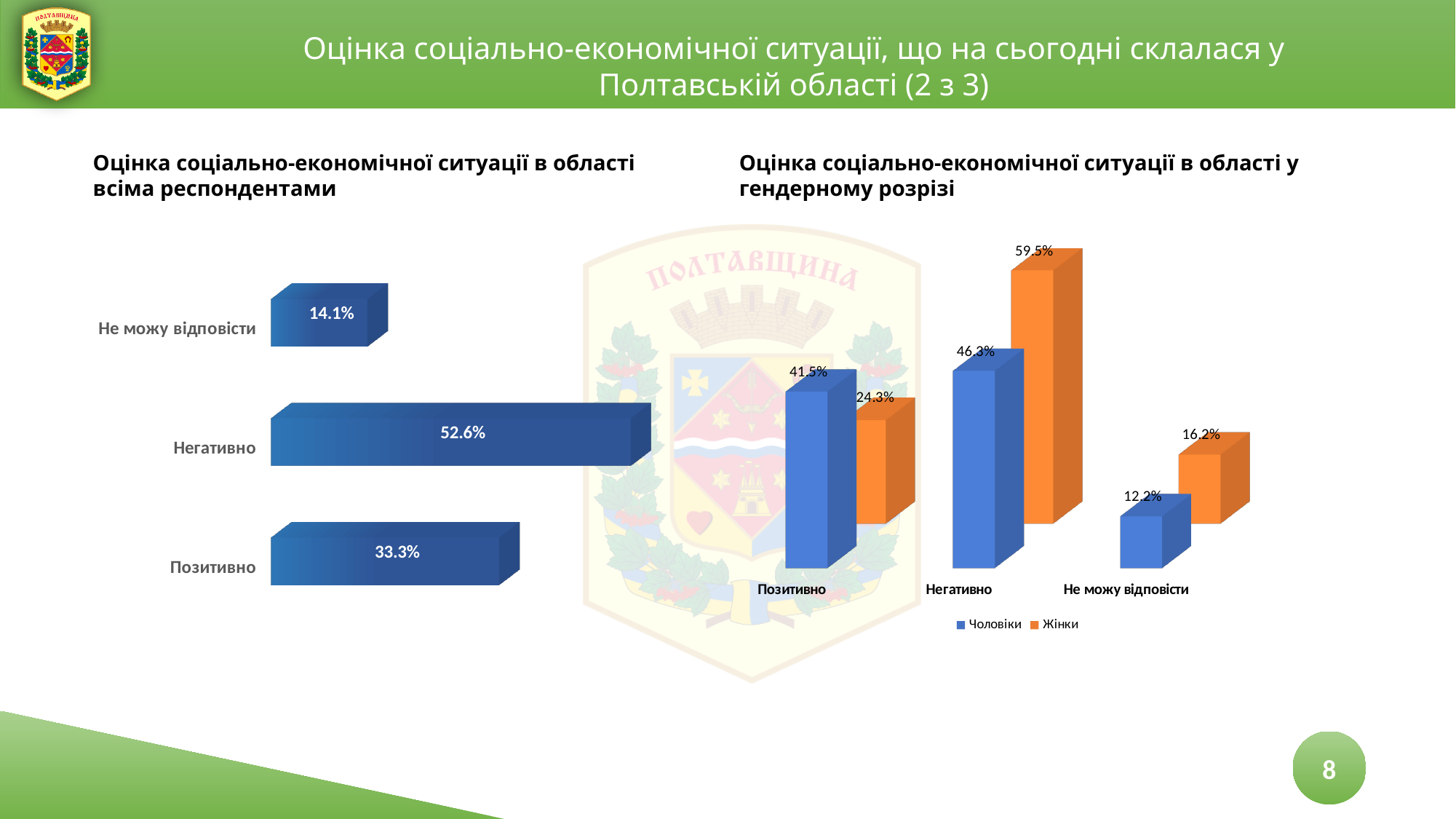
In the right chart (gender breakdown), how many series does the legend list? 2 In the left chart (all respondents), what is the value for Не можу відповісти? 14.1% In the right chart (gender breakdown), what is the value for Жінки in the Негативно category? 59.5% In the left chart (all respondents), what is the difference between Негативно and Позитивно? 19.3% In the left chart (all respondents), what is the value for Негативно? 52.6% In the right chart (gender breakdown), what is the difference between Жінки and Чоловіки in the Не можу відповісти category? 4.0% In the left chart (all respondents), which category has the lowest value? Не можу відповісти In the right chart (gender breakdown), which is larger for Позитивно: Чоловіки or Жінки? Чоловіки In the right chart (gender breakdown), what is the value for Чоловіки in the Позитивно category? 41.5% In the left chart (all respondents), how many categories are shown? 3 In the left chart (all respondents), which category has the highest value? Негативно What kind of chart is the right chart (gender breakdown)? Bar chart